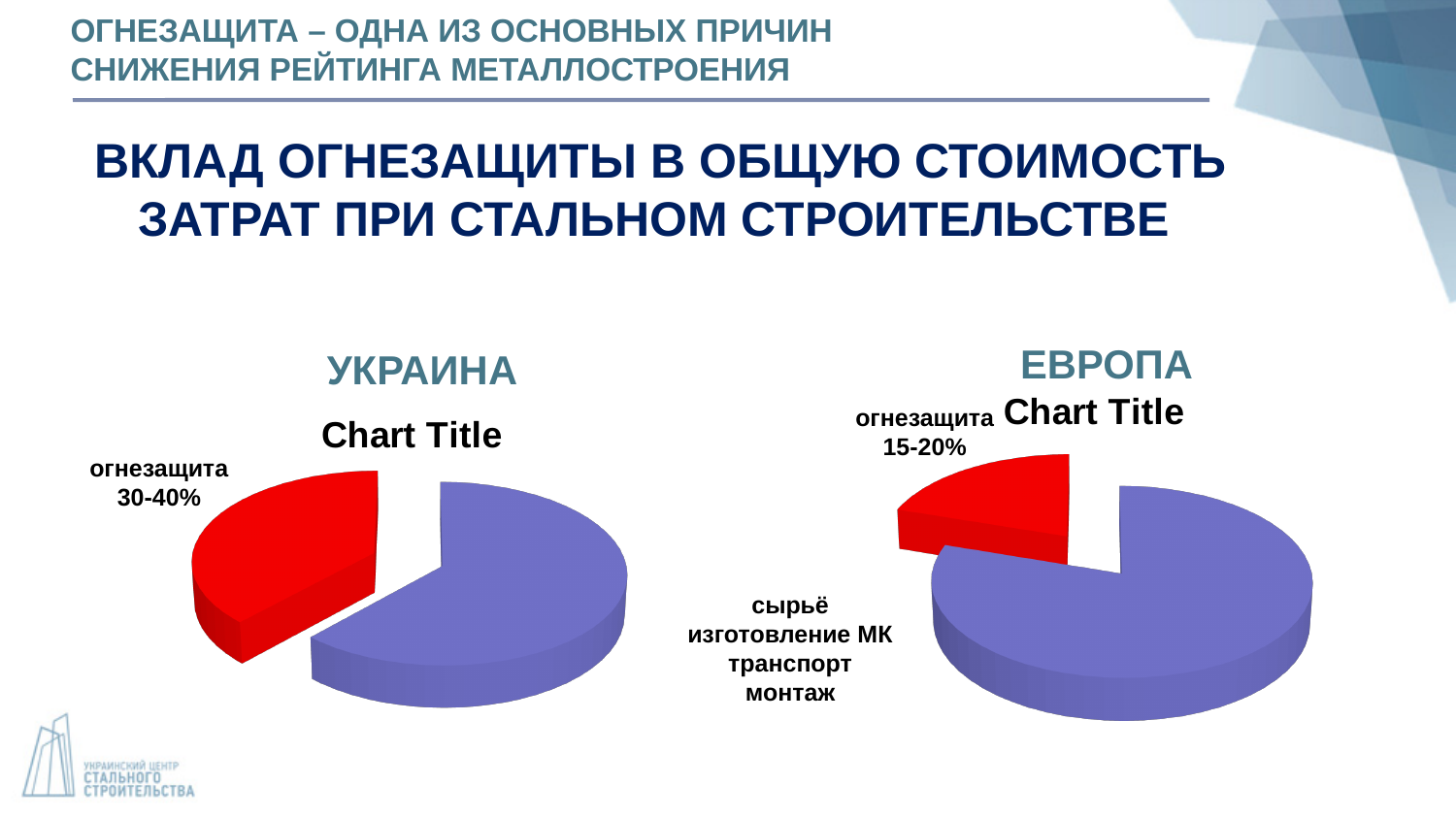
What title text is printed above each pie chart? Chart Title What colour is the огнезащита slice in both pie charts? red In the УКРАИНА chart, what share of costs is labelled for огнезащита? 30-40% What kind of chart is used for ЕВРОПА? pie chart Which chart shows a larger share for огнезащита, УКРАИНА or ЕВРОПА? УКРАИНА In the ЕВРОПА chart, what share of costs is labelled for огнезащита? 15-20% In the УКРАИНА chart, which slice is larger: огнезащита or the purple slice? the purple slice How many slices does the ЕВРОПА pie chart have? 2 How many slices does the УКРАИНА pie chart have? 2 What kind of chart is used for УКРАИНА? pie chart In the ЕВРОПА chart, which slice is smaller: огнезащита or the purple slice? огнезащита